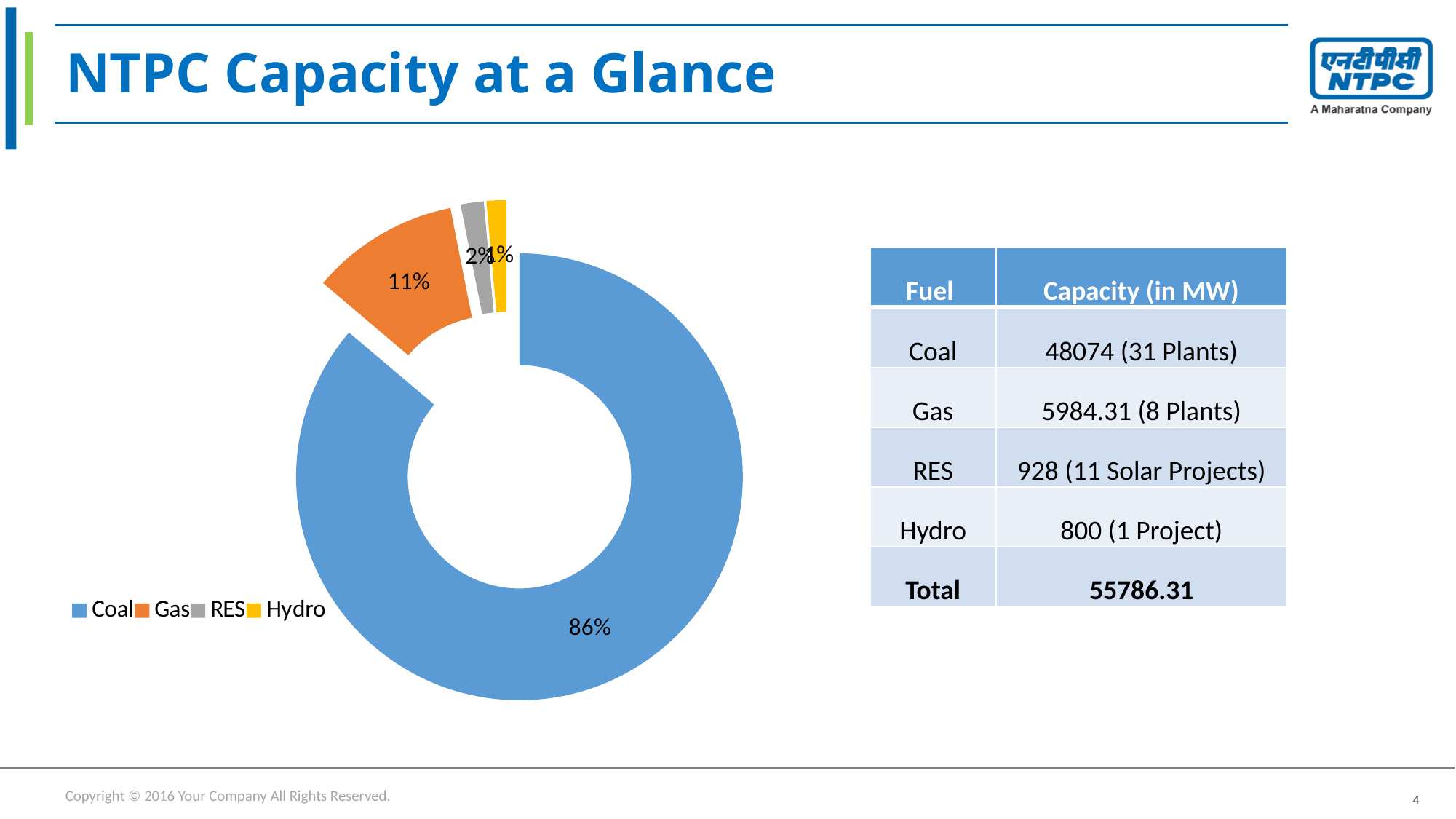
What share of the pie chart does Gas account for? 11% What is the difference in percentage points between the Coal and Gas slices? 75 What kind of chart is shown on the slide? doughnut chart Which fuel has the smallest slice in the pie chart? Hydro Which slice is larger in the pie chart, Gas or RES? Gas What share of the pie chart does Hydro account for? 1% Which fuel has the largest slice in the pie chart? Coal How many entries does the chart legend list? 4 How many slices does the pie chart have? 4 What colour is the Gas slice in the pie chart? orange What share of the pie chart does RES account for? 2%